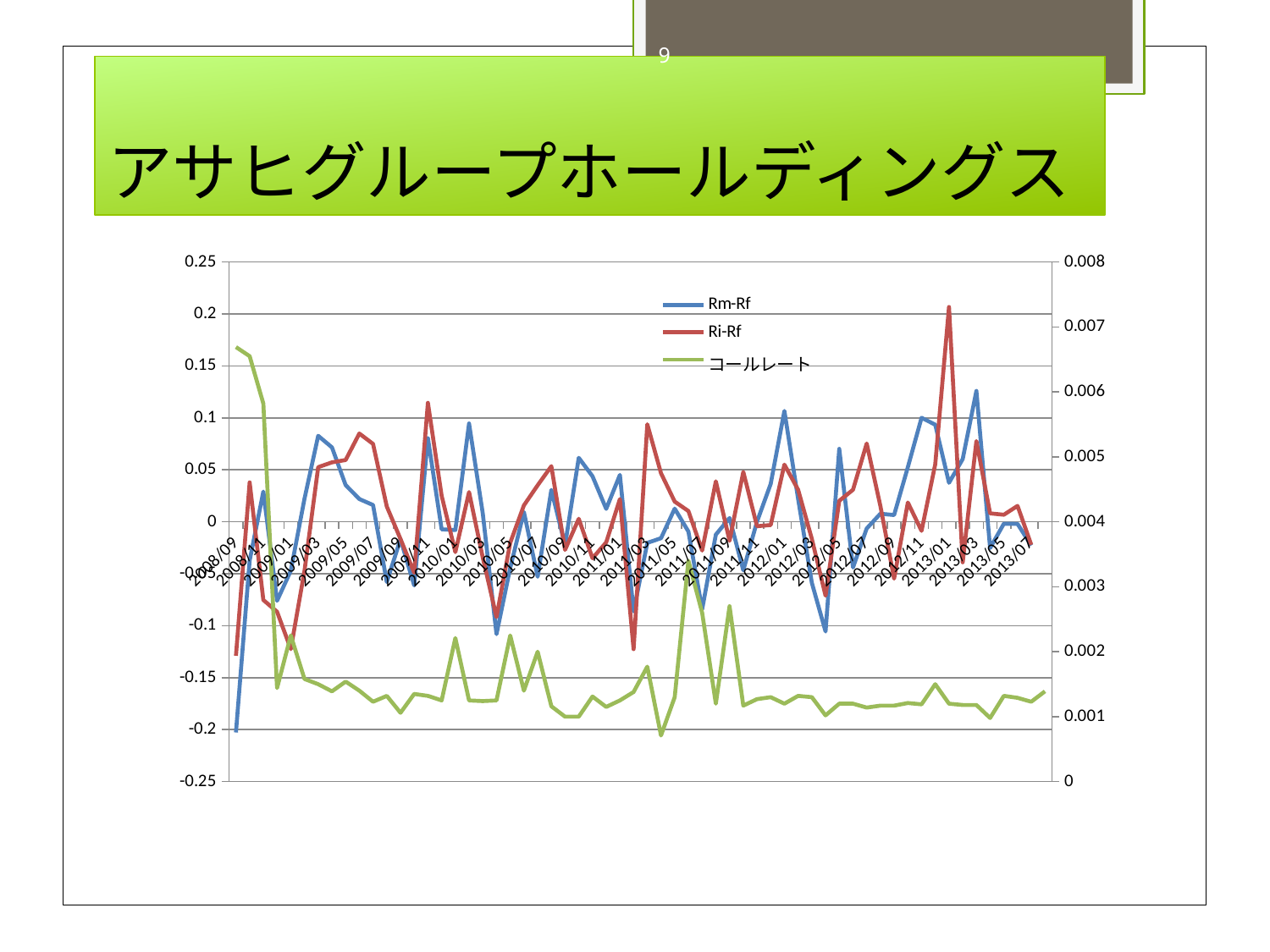
Is the lowest value of the コールレート series greater or less than 0.001 on the right axis? less How many series does the chart's legend list? 3 What kind of chart is shown on the slide? line chart What is the title of the slide containing the chart? アサヒグループホールディングス Overall, does the コールレート series rise or fall from 2008/09 to 2013/07? fall Which series has the highest peak on the left axis, Rm-Rf or Ri-Rf? Ri-Rf Is the highest value of the Ri-Rf series greater or less than 0.15 on the left axis? greater Is the value of Rm-Rf at 2008/09 greater or less than -0.1 on the left axis? less Which colour is used for the Ri-Rf series in the chart? red